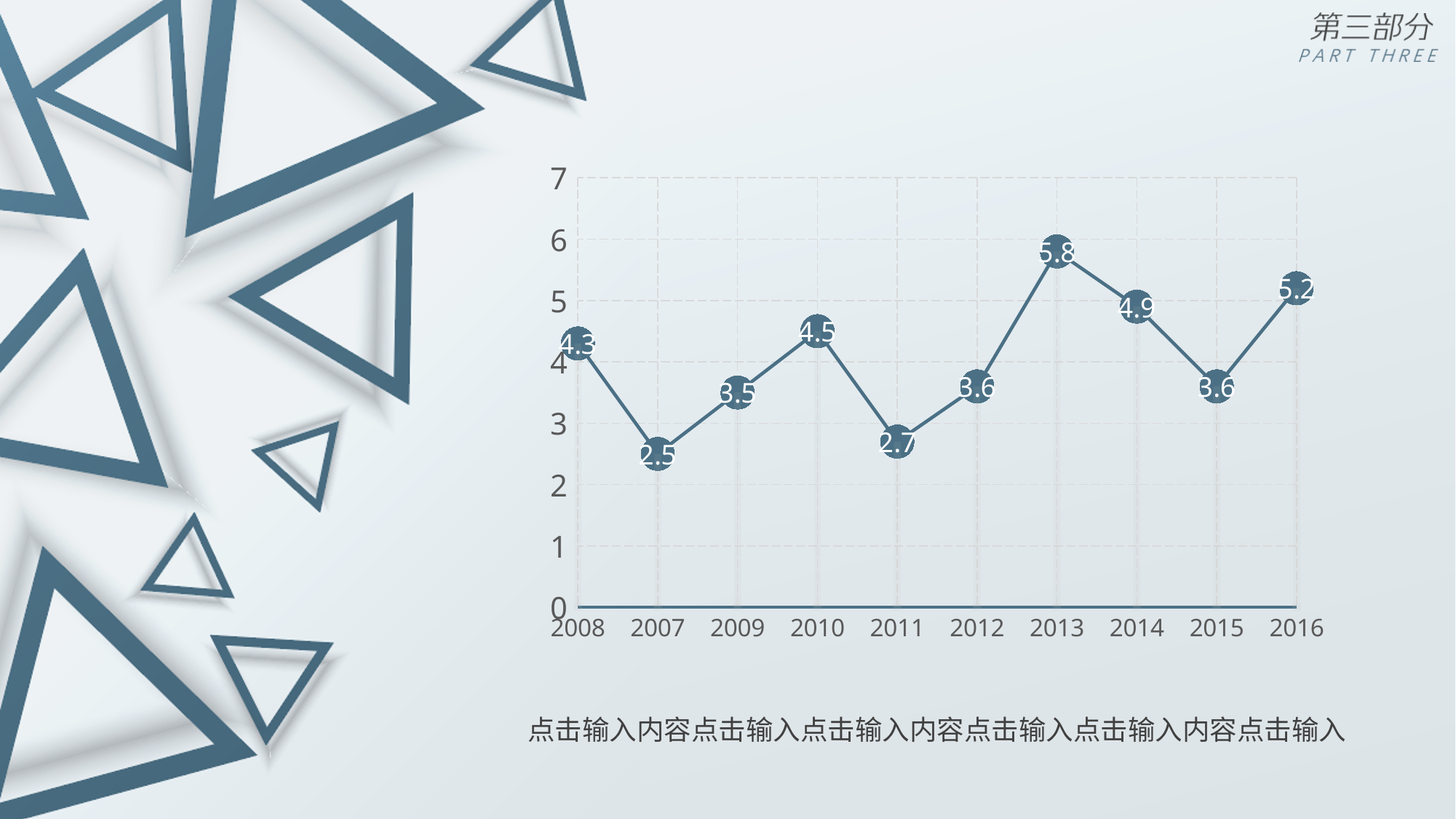
Which year has the highest value on the chart? 2013 How many data points are plotted on the chart? 10 What type of chart is shown on the slide? line chart Which year label appears first on the x axis of the chart? 2008 What is the value plotted for 2011? 2.7 What is the value plotted for 2016? 5.2 What is the value plotted for 2013? 5.8 Which year has the lowest value on the chart? 2007 What is the value plotted for 2007? 2.5 What is the difference between the values for 2013 and 2014? 0.9 What is the difference between the values for 2010 and 2011? 1.8 Which is larger, the value for 2008 or the value for 2009? 2008